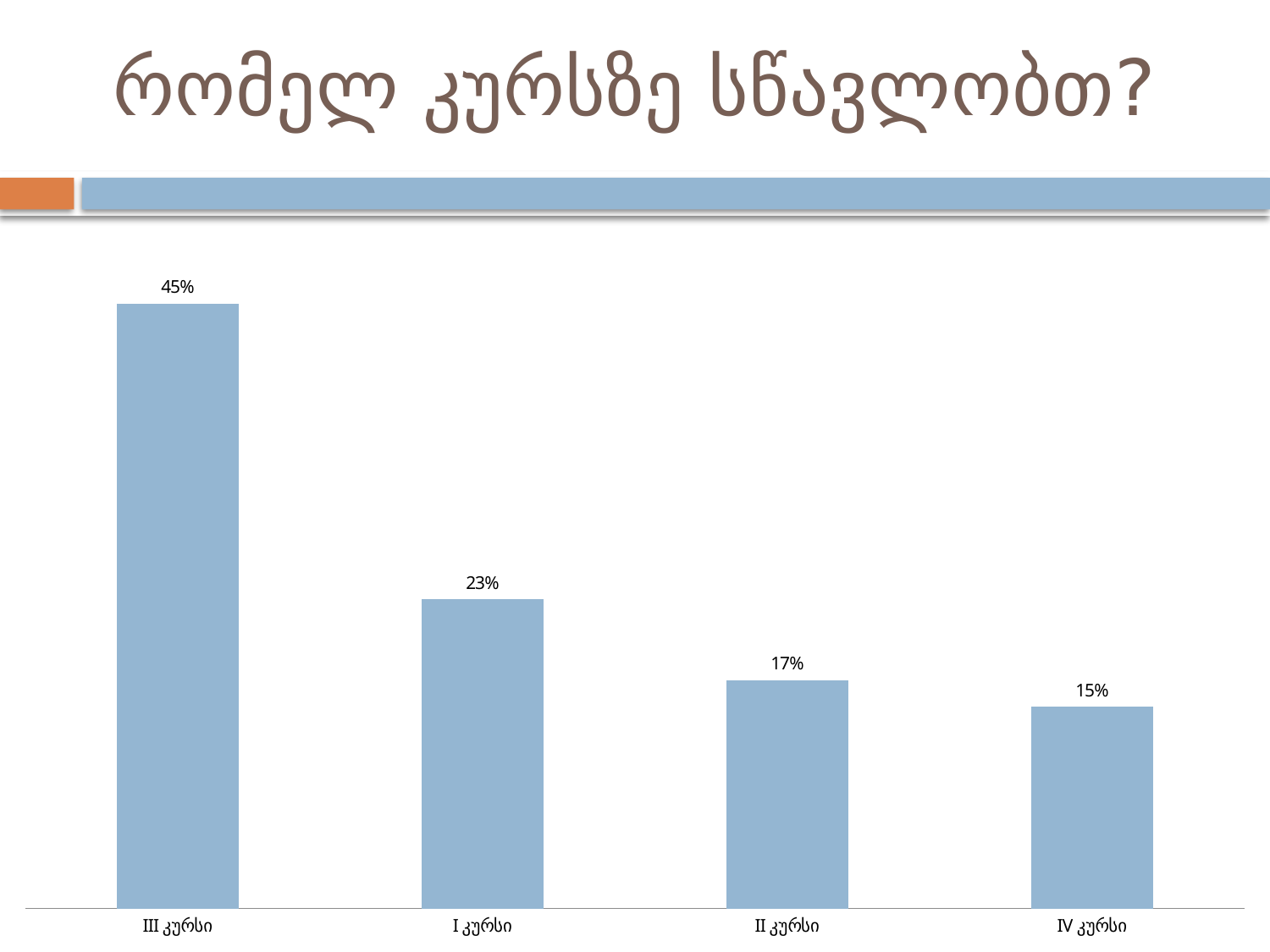
What kind of chart is shown on the slide? bar chart What is the value for IV კურსი? 15% What is the value for II კურსი? 17% How many categories are shown in the chart? 4 Which category has the lowest value? IV კურსი Which category has the highest value? III კურსი What is the difference between the values for III კურსი and I კურსი? 22% What is the value for I კურსი? 23% What is the value for III კურსი? 45% What is the difference between the values for II კურსი and IV კურსი? 2% What is the title of the slide? რომელ კურსზე სწავლობთ? Which is larger, the value for I კურსი or the value for II კურსი? I კურსი